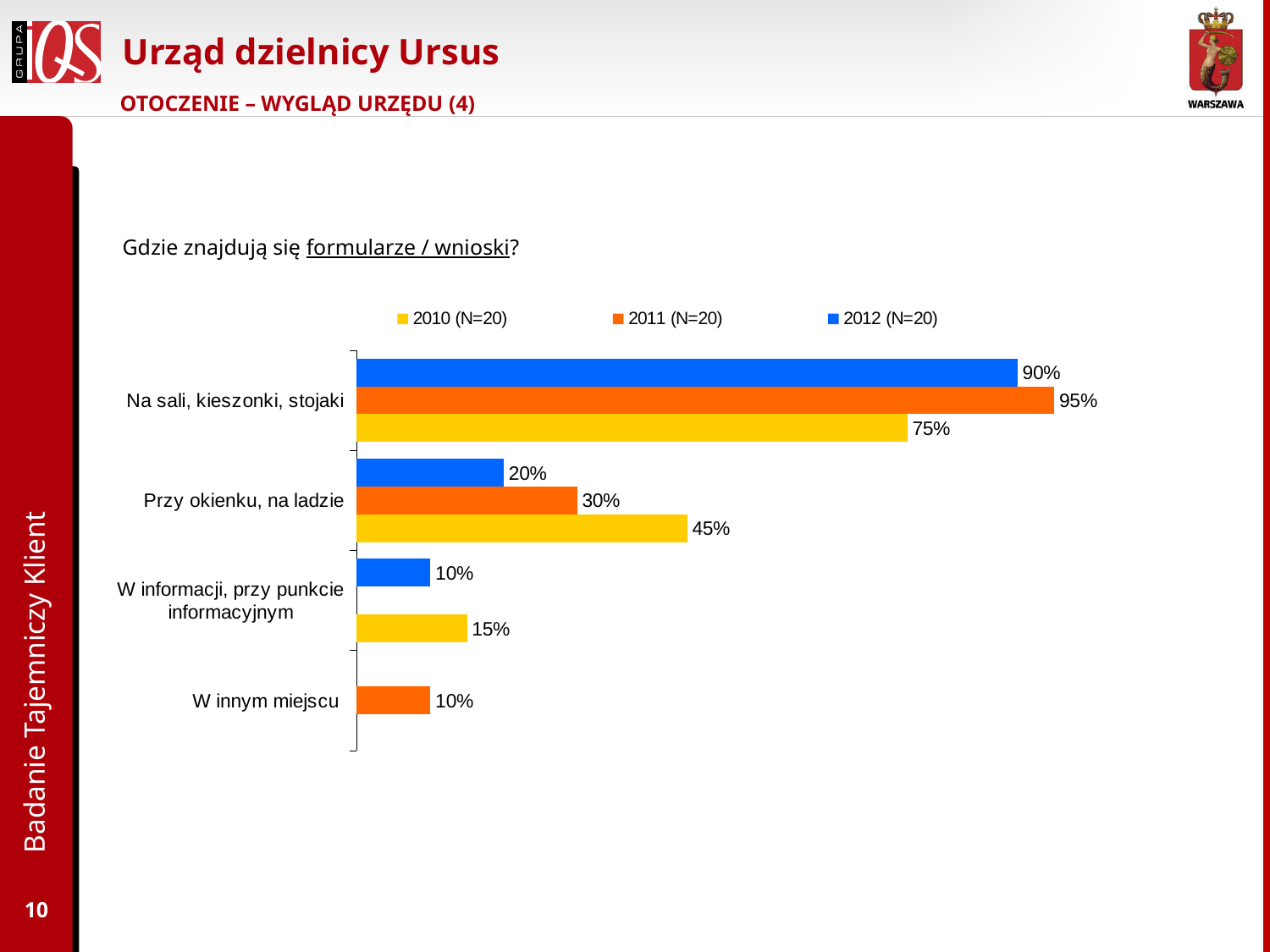
Which category has the highest value for 2012 (N=20)? Na sali, kieszonki, stojaki How many series does the legend list? 3 What is the value for 2011 (N=20) in the category "Na sali, kieszonki, stojaki"? 95% What kind of chart is shown on the slide? Bar chart What is the difference between the 2011 (N=20) and 2010 (N=20) values for "Na sali, kieszonki, stojaki"? 20% What is the value for 2011 (N=20) in the category "W innym miejscu"? 10% How many categories are shown on the chart? 4 Which is larger for "Przy okienku, na ladzie": the 2010 (N=20) value or the 2011 (N=20) value? 2010 (N=20) What is the value for 2010 (N=20) in the category "Przy okienku, na ladzie"? 45% What colour represents the 2012 (N=20) series? Blue What is the value for 2012 (N=20) in the category "W informacji, przy punkcie informacyjnym"? 10% Which year series has the lowest value in the category "Przy okienku, na ladzie"? 2012 (N=20)